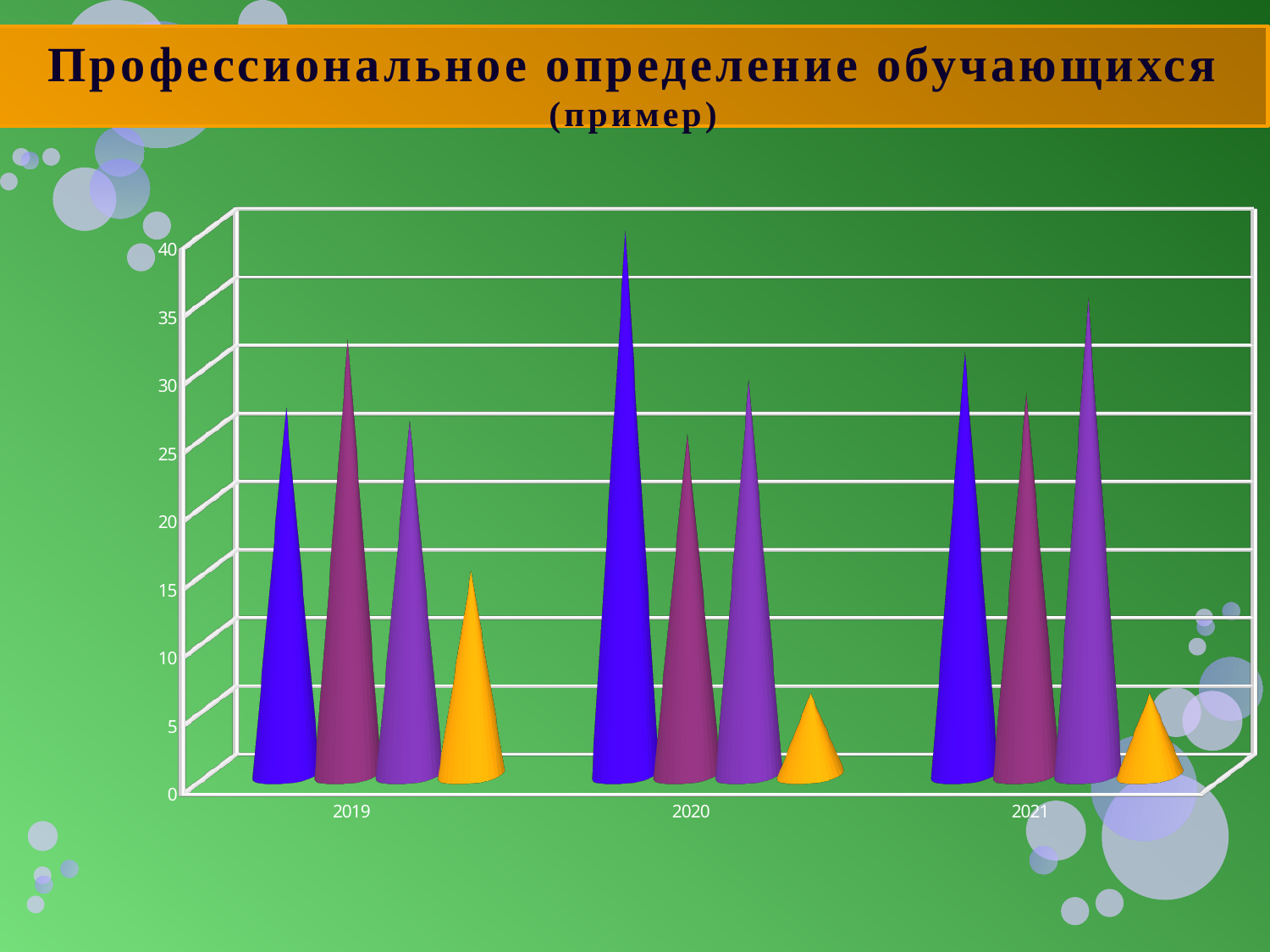
Is the value of the violet bar for 2021 greater or less than 30? greater Which year has the tallest orange bar? 2019 What is the title of the chart slide? Профессиональное определение обучающихся (пример) Is the value of the blue bar for 2020 greater or less than 35? greater How many differently coloured bars are shown for each year in the chart? 4 Which year has the tallest blue bar? 2020 What kind of chart is shown on the slide? bar chart Is the value of the orange bar for 2020 greater or less than 10? less How many categories are shown on the x axis of the chart? 3 Which is larger in 2021, the violet bar or the magenta bar? the violet bar Which is larger in 2019, the blue bar or the orange bar? the blue bar